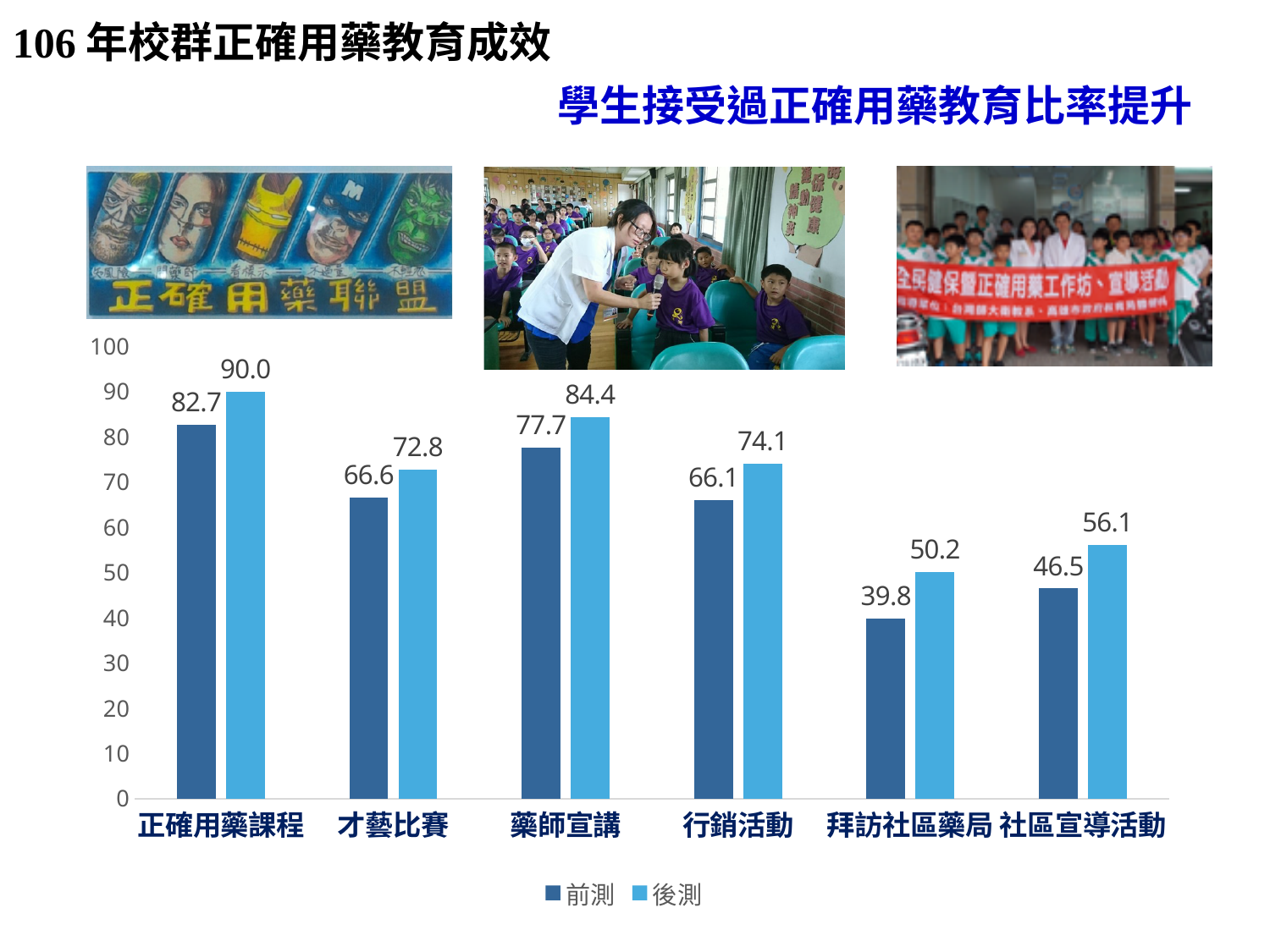
How many series does the legend list? 2 Which series is shown in the lighter blue colour? 後測 What is the 後測 value for 正確用藥課程? 90.0 What is the difference between the 後測 and 前測 values for 才藝比賽? 6.2 What is the 後測 value for 藥師宣講? 84.4 Which is larger, the 前測 value for 行銷活動 or the 前測 value for 社區宣導活動? 行銷活動 Which category has the highest 前測 value? 正確用藥課程 What is the difference between the 後測 and 前測 values for 拜訪社區藥局? 10.4 How many categories are shown on the x axis? 6 What is the 前測 value for 拜訪社區藥局? 39.8 Which category has the lowest 後測 value? 拜訪社區藥局 What kind of chart is shown on the slide? bar chart